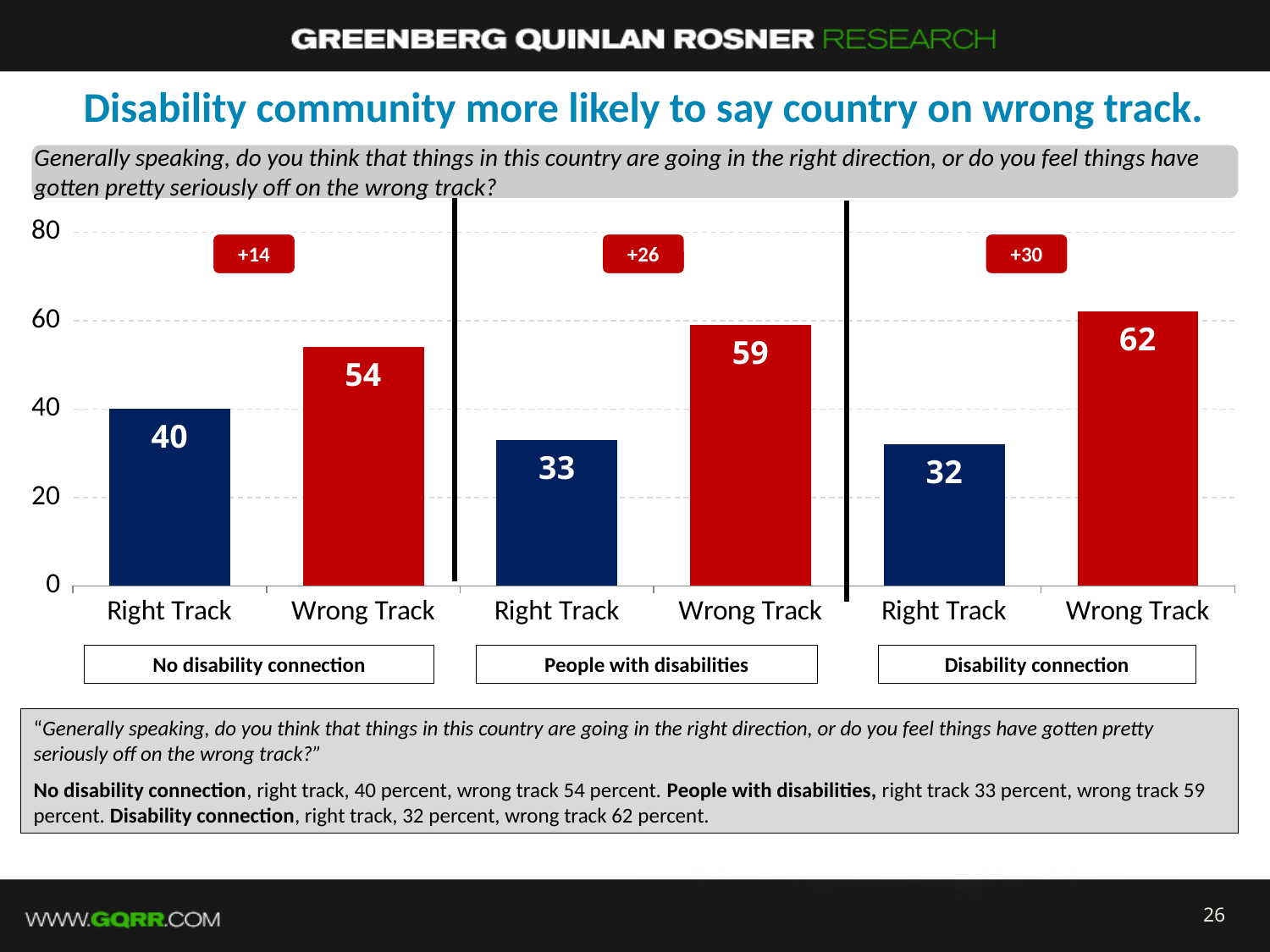
What is the difference between Wrong Track and Right Track for People with disabilities? 26 What is the Right Track value for the Disability connection group? 32 Which group has the highest Wrong Track value? Disability connection What is the Right Track value for the No disability connection group? 40 What is the Wrong Track value for the Disability connection group? 62 What is the Wrong Track value for People with disabilities? 59 How many bars are plotted on the chart? 6 What kind of chart is shown on the slide? Bar chart Which is larger: Right Track for No disability connection or Right Track for People with disabilities? Right Track for No disability connection Which group has the lowest Right Track value? Disability connection What is the difference between the Wrong Track values for Disability connection and No disability connection? 8 What margin label is shown above the No disability connection bars? +14